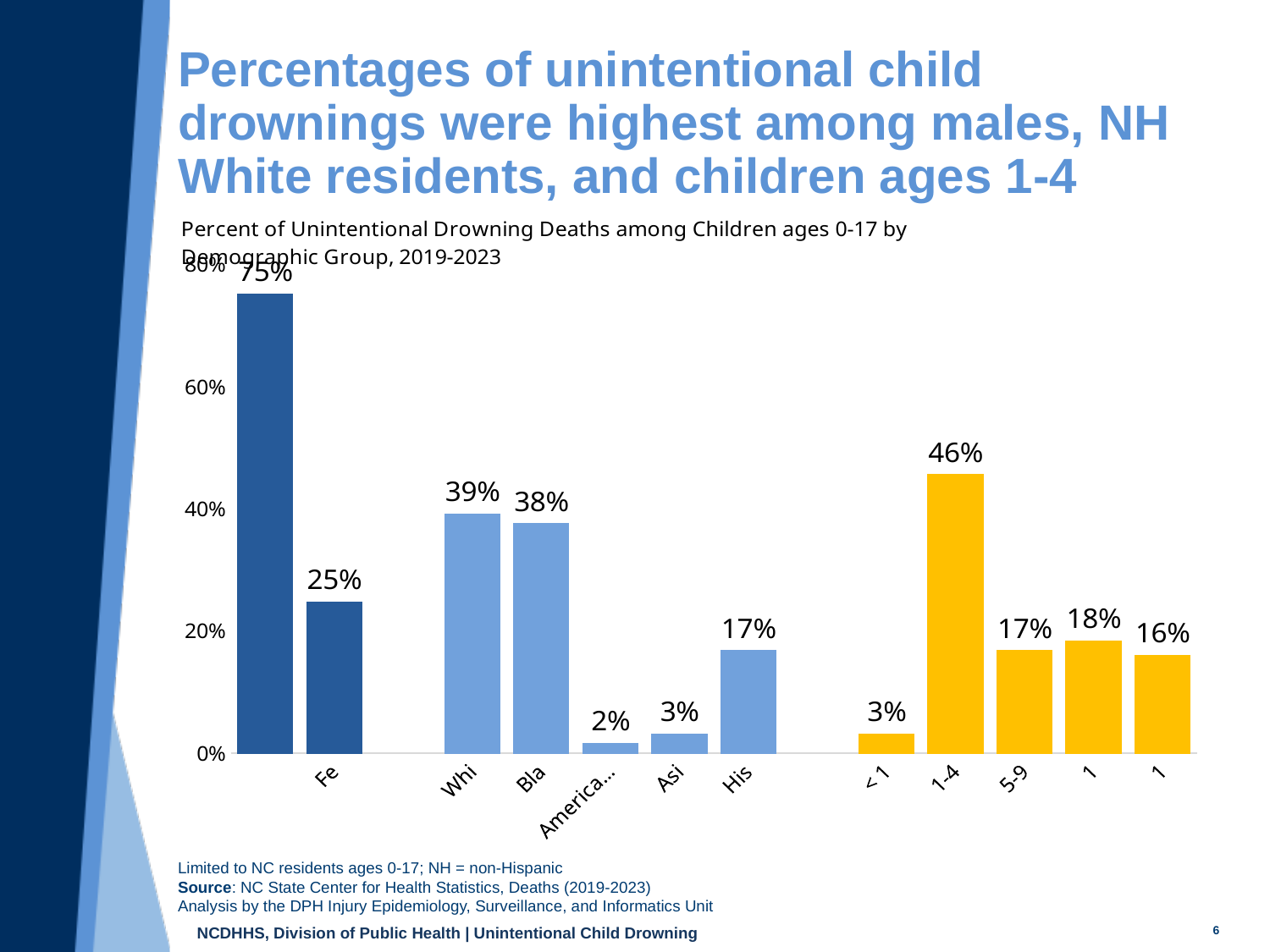
What kind of chart is shown on the slide? Bar chart Is the value for the age group "5-9" greater or less than 20%? less What is the difference between the values for "Whi" and "Bla"? 1% What is the value for the category labeled "Whi"? 39% What is the value for the age group "1-4"? 46% Among the yellow age-group bars, which category has the highest value? 1-4 What is the value for the category labeled "Fe"? 25% What is the lowest value shown on the chart? 2% What is the value for the category labeled "His"? 17% Which is larger, the value for "1-4" or the value for "Fe"? 1-4 What is the value for the category labeled "Bla"? 38% What is the value for the age group "< 1"? 3%